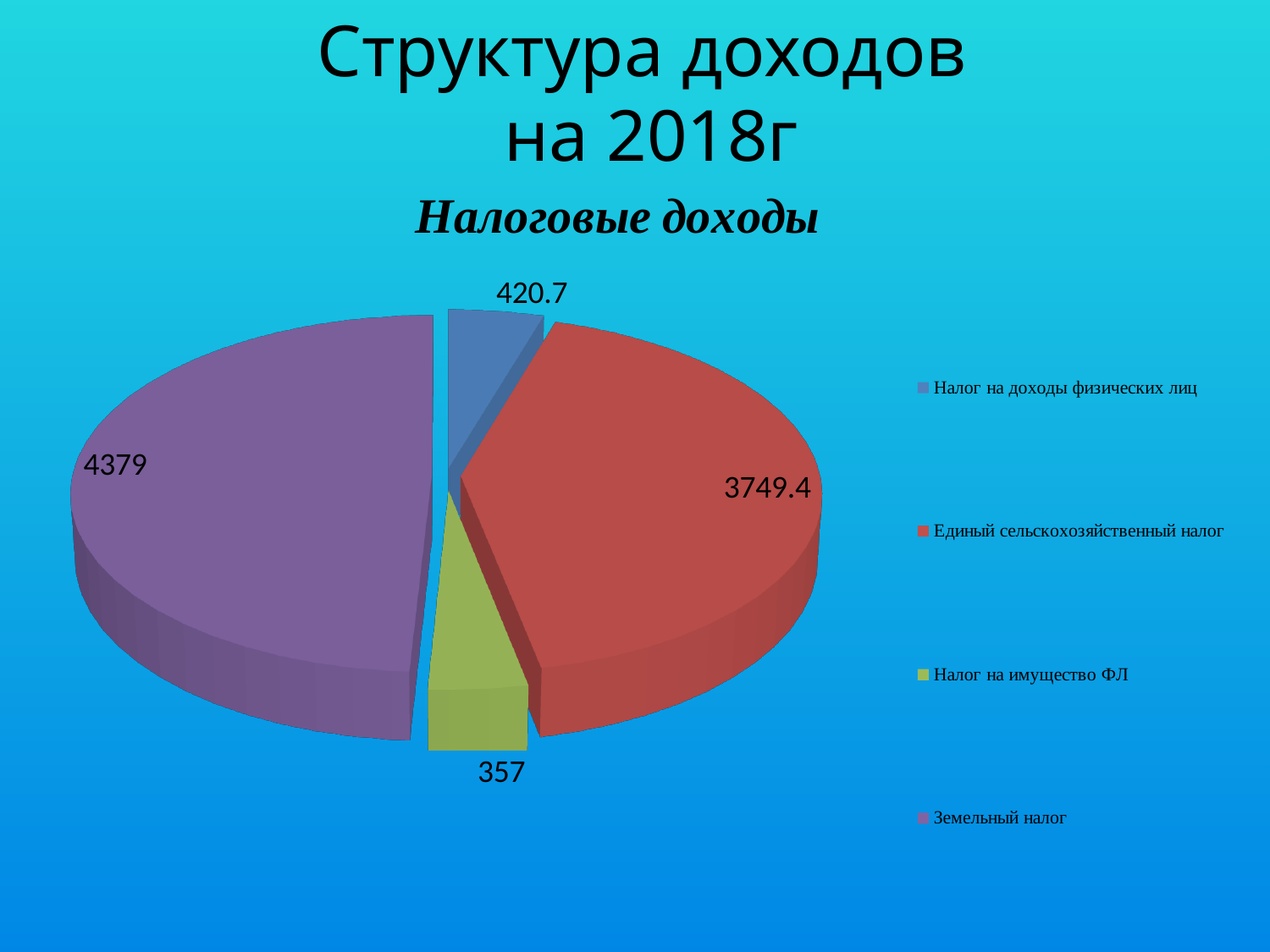
What is the value shown for Налог на доходы физических лиц? 420.7 What is the value shown for Единый сельскохозяйственный налог? 3749.4 What is the difference between the values for Земельный налог and Единый сельскохозяйственный налог? 629.6 What is the value shown for Земельный налог? 4379 Which category has the smallest slice of the pie? Налог на имущество ФЛ What colour is the slice for Единый сельскохозяйственный налог? Red How many categories are shown in the pie chart? 4 Which category has the largest slice of the pie? Земельный налог What is the difference between the values for Налог на доходы физических лиц and Налог на имущество ФЛ? 63.7 What is the value shown for Налог на имущество ФЛ? 357 What kind of chart is shown on the slide? Pie chart Which is larger: the value for Налог на доходы физических лиц or the value for Налог на имущество ФЛ? Налог на доходы физических лиц